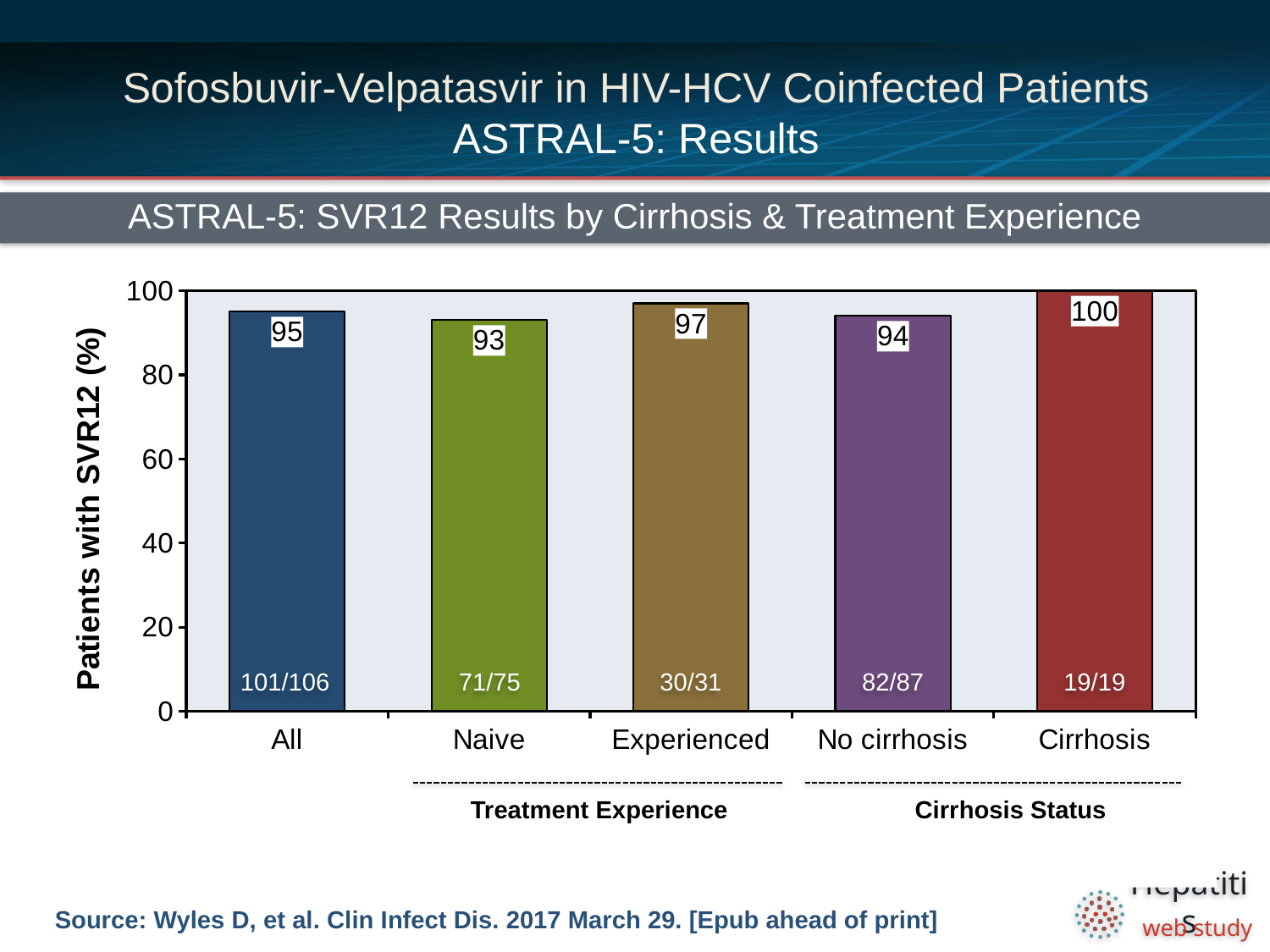
What is the label of the y axis? Patients with SVR12 (%) What kind of chart is shown on the slide? Bar chart What is the SVR12 rate for the All group? 95 Which has a higher SVR12 rate, No cirrhosis or Cirrhosis? Cirrhosis What is the difference in SVR12 rate between the Experienced and Naive groups? 4 Which category has the highest SVR12 rate? Cirrhosis What fraction of patients is shown inside the Experienced bar? 30/31 What is the title of the chart? ASTRAL-5: SVR12 Results by Cirrhosis & Treatment Experience What is the SVR12 rate for the Naive group? 93 How many categories are shown on the x axis? 5 Which category has the lowest SVR12 rate? Naive What is the SVR12 rate for the Cirrhosis group? 100